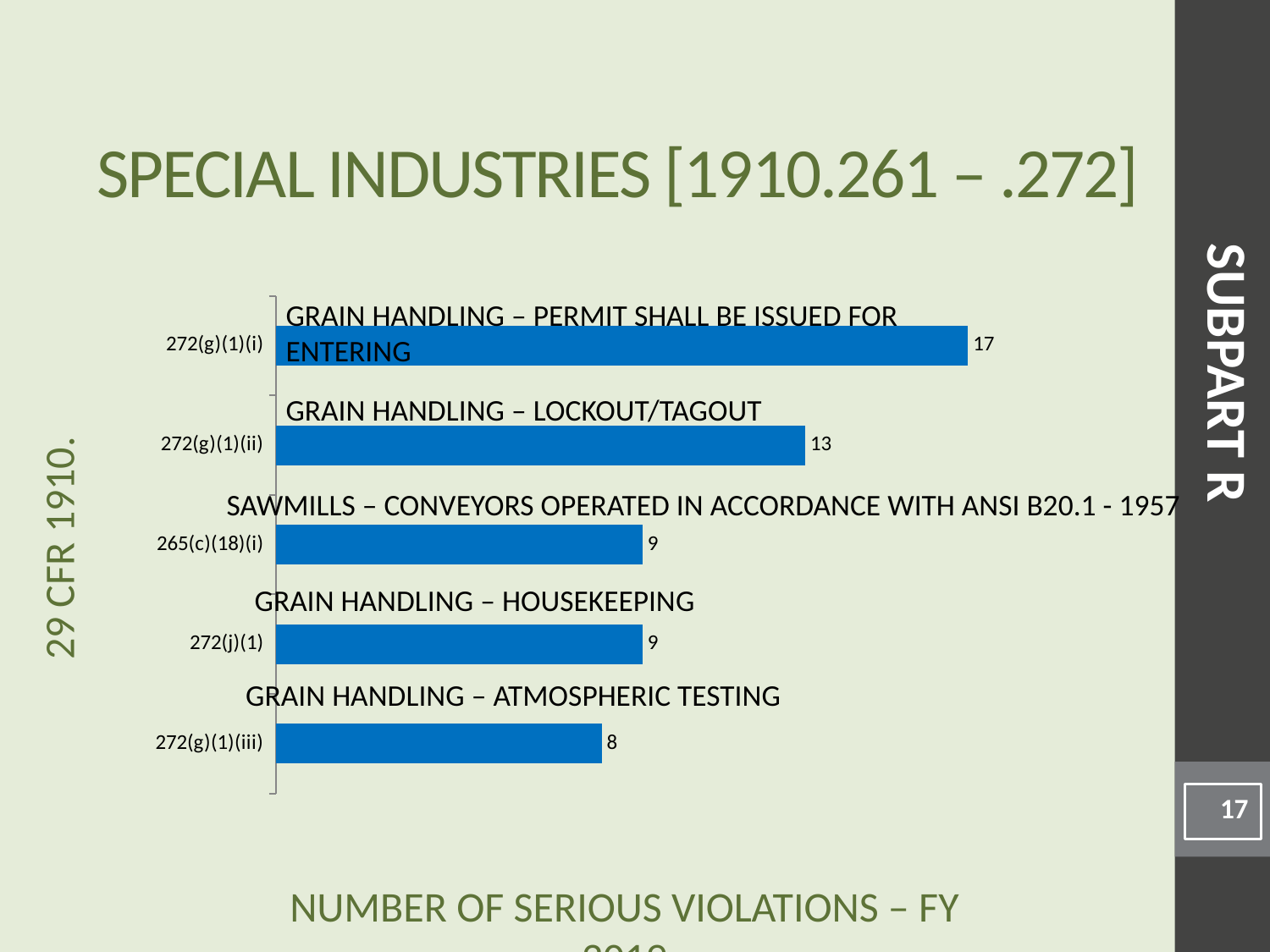
How many standards (bars) are shown in the chart? 5 Which standard has the lowest number of serious violations? 272(g)(1)(iii) What is the difference between the number of serious violations for 272(g)(1)(i) and 272(g)(1)(ii)? 4 What is the number of serious violations for 272(g)(1)(ii)? 13 What is the number of serious violations for 265(c)(18)(i)? 9 Which standard has the highest number of serious violations? 272(g)(1)(i) What is the difference between the number of serious violations for 272(g)(1)(ii) and 272(j)(1)? 4 What is the number of serious violations for 272(g)(1)(iii)? 8 Which standard is labelled 'GRAIN HANDLING – LOCKOUT/TAGOUT' in the chart? 272(g)(1)(ii) Which has more serious violations, 272(g)(1)(ii) or 265(c)(18)(i)? 272(g)(1)(ii) What kind of chart is shown on the slide? Bar chart What is the number of serious violations for 272(g)(1)(i)? 17